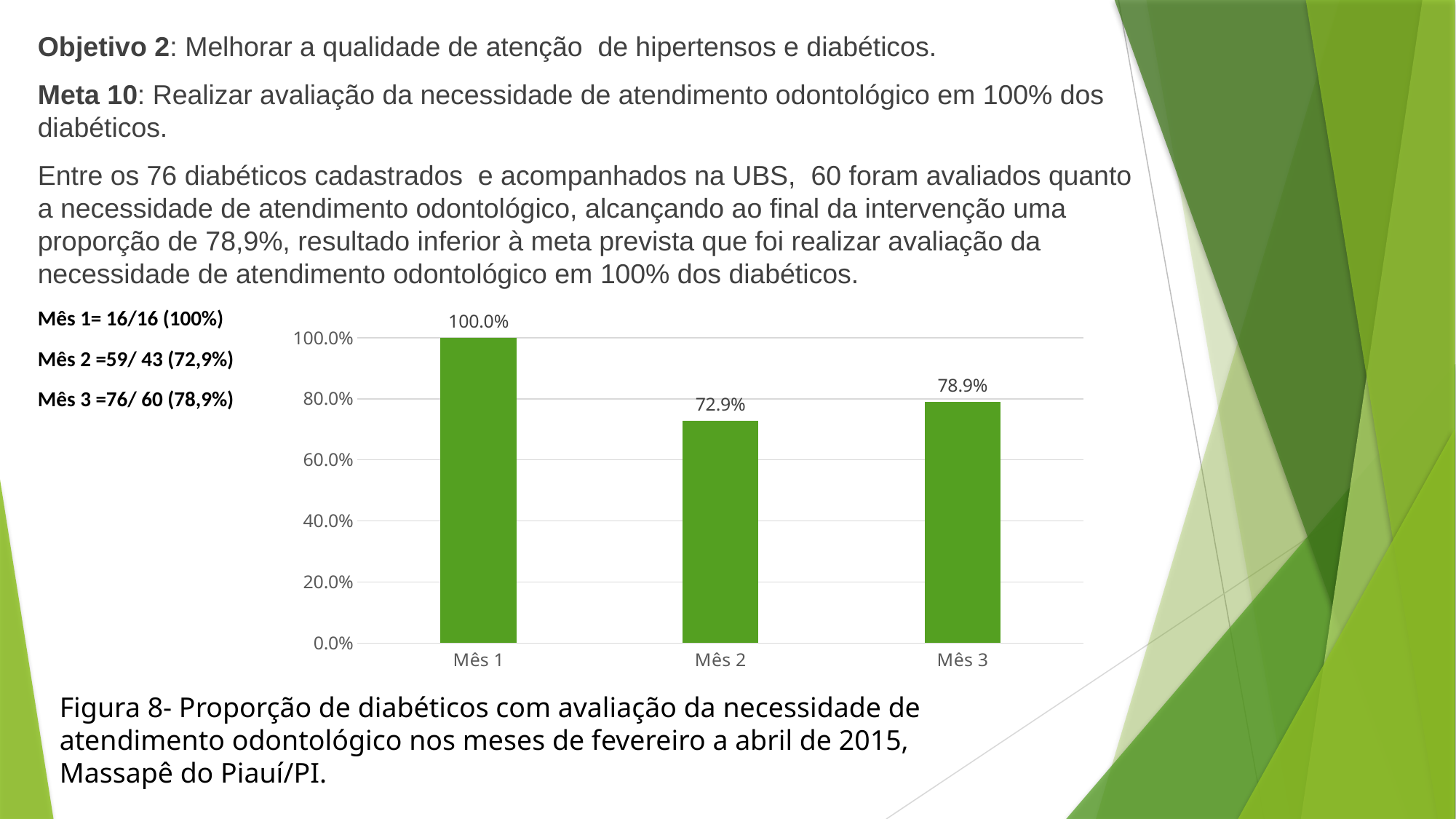
What is the value for Mês 3? 78.9% What is the difference between the values for Mês 3 and Mês 2? 6.0% Is the value for Mês 2 greater or less than 80.0%? less What colour are the bars in the chart? green What is the difference between the values for Mês 1 and Mês 2? 27.1% Which month has the lowest value? Mês 2 How many months are shown on the x axis? 3 What kind of chart is shown on the slide? bar chart Which month has the highest value? Mês 1 What is the value for Mês 2? 72.9% What is the value for Mês 1? 100.0% Which is larger, the value for Mês 2 or Mês 3? Mês 3